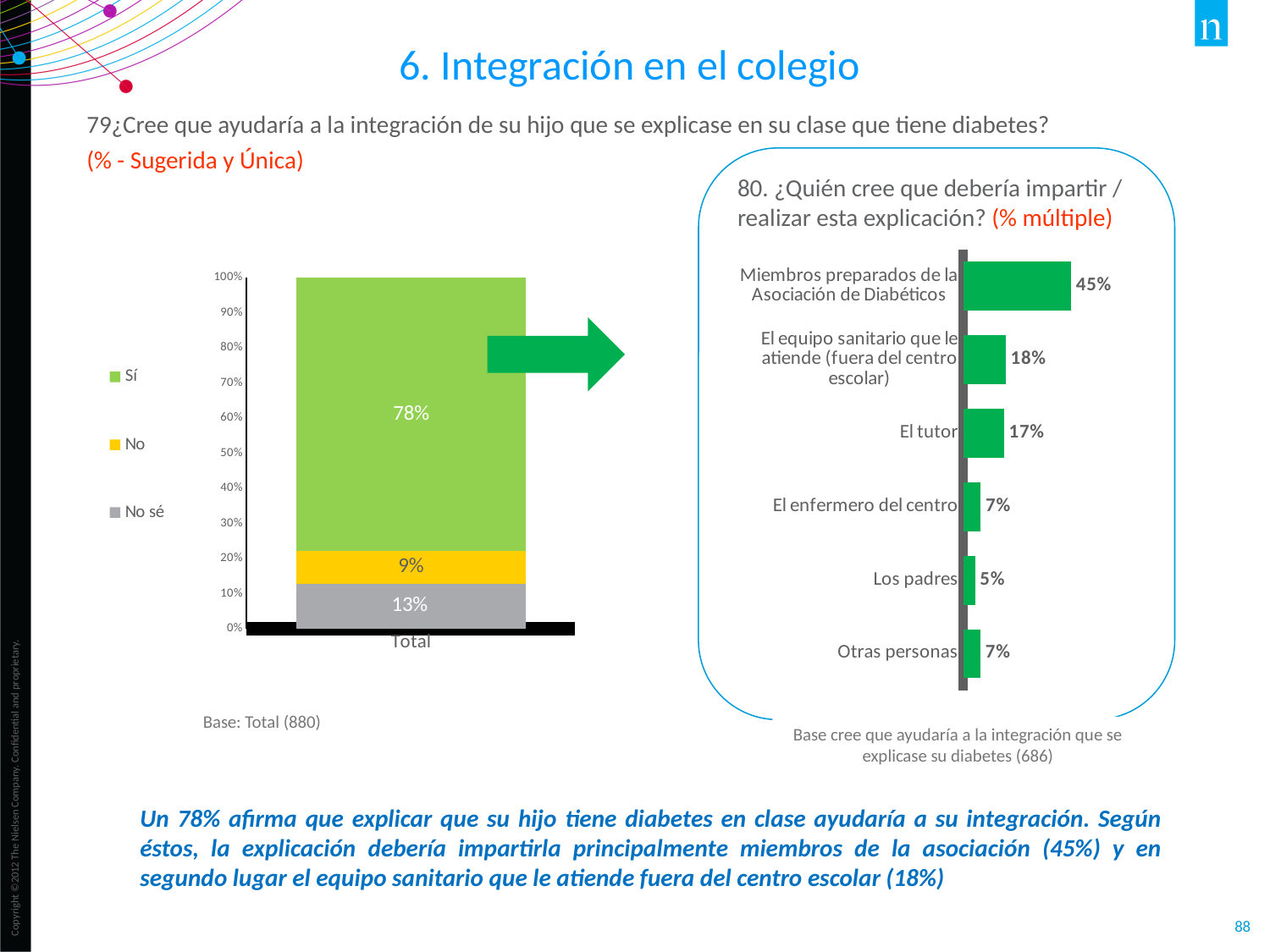
How many series does the legend of the left stacked bar chart (question 79) list? 3 In the left stacked bar chart (question 79), which response has the smallest share? No In the right bar chart (question 80), which category has the lowest value? Los padres In the left stacked bar chart (question 79), what is the difference between the "No sé" and "No" shares? 4% In the right bar chart (question 80), what is the value for "El tutor"? 17% In the right bar chart (question 80), how many categories are shown? 6 What type of chart is the right chart (question 80)? Bar chart In the left stacked bar chart (question 79), what percentage answered "No sé"? 13% In the right bar chart (question 80), what is the value for "Los padres"? 5% In the left stacked bar chart (question 79), what percentage answered "Sí"? 78% In the right bar chart (question 80), which category has the highest value? Miembros preparados de la Asociación de Diabéticos In the right bar chart (question 80), what is the difference between "Miembros preparados de la Asociación de Diabéticos" and "El equipo sanitario que le atiende (fuera del centro escolar)"? 27%